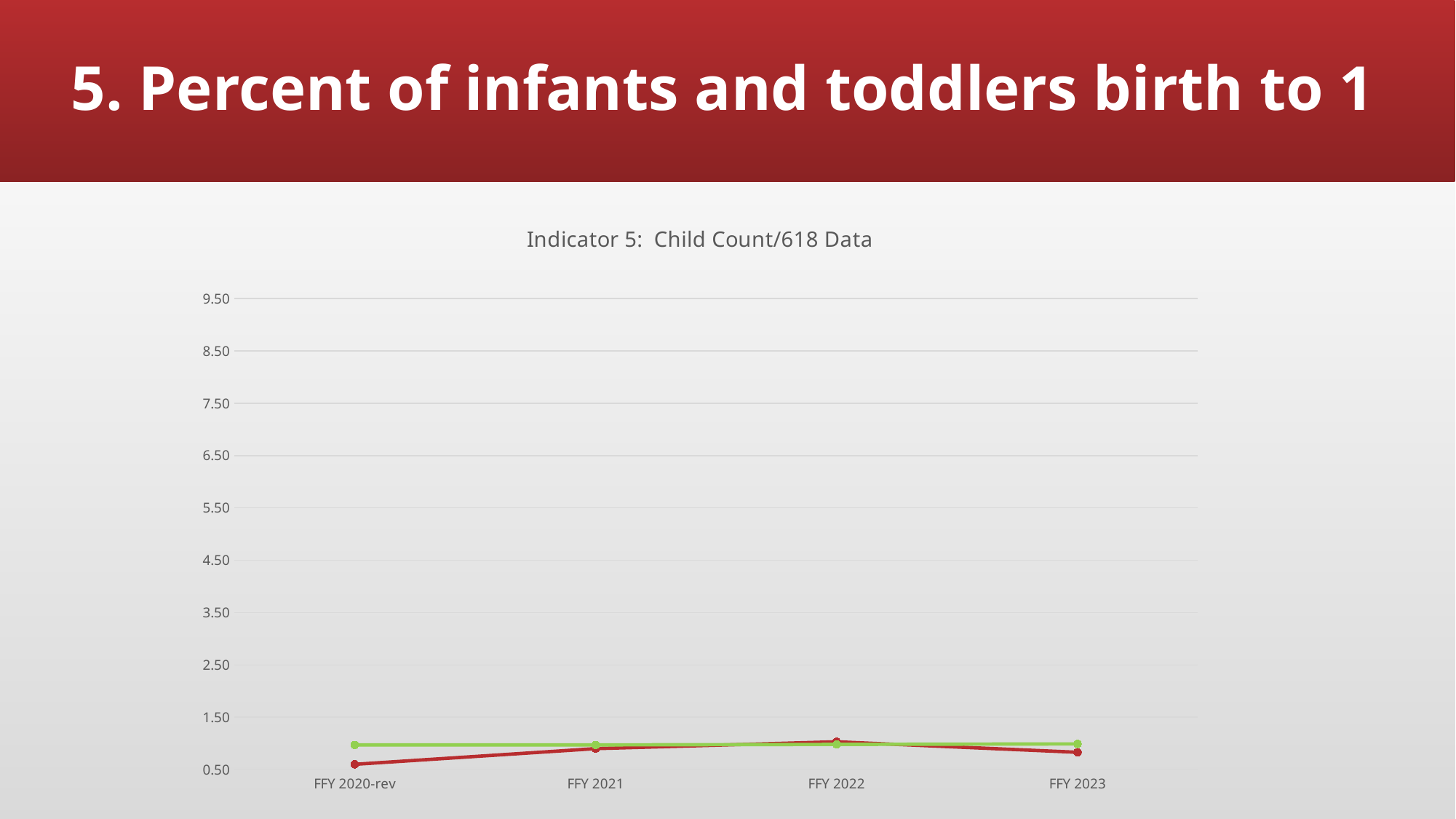
What is the title of the chart? Indicator 5: Child Count/618 Data What kind of chart is shown on the slide? line chart Is the value of the red line at FFY 2020-rev greater or less than 1.50? less Is the value of the red line at FFY 2022 greater or less than 2.50? less At FFY 2020-rev, which line has the higher value, the green line or the red line? green line Does the red line rise or fall from FFY 2020-rev to FFY 2022? rise Is the value of the green line at FFY 2023 greater or less than 1.50? less How many categories are shown on the x axis of the chart? 4 What is the first category label on the x axis? FFY 2020-rev At FFY 2023, which line has the higher value, the green line or the red line? green line At which category does the red line reach its lowest value? FFY 2020-rev How many lines are plotted on the chart? 2